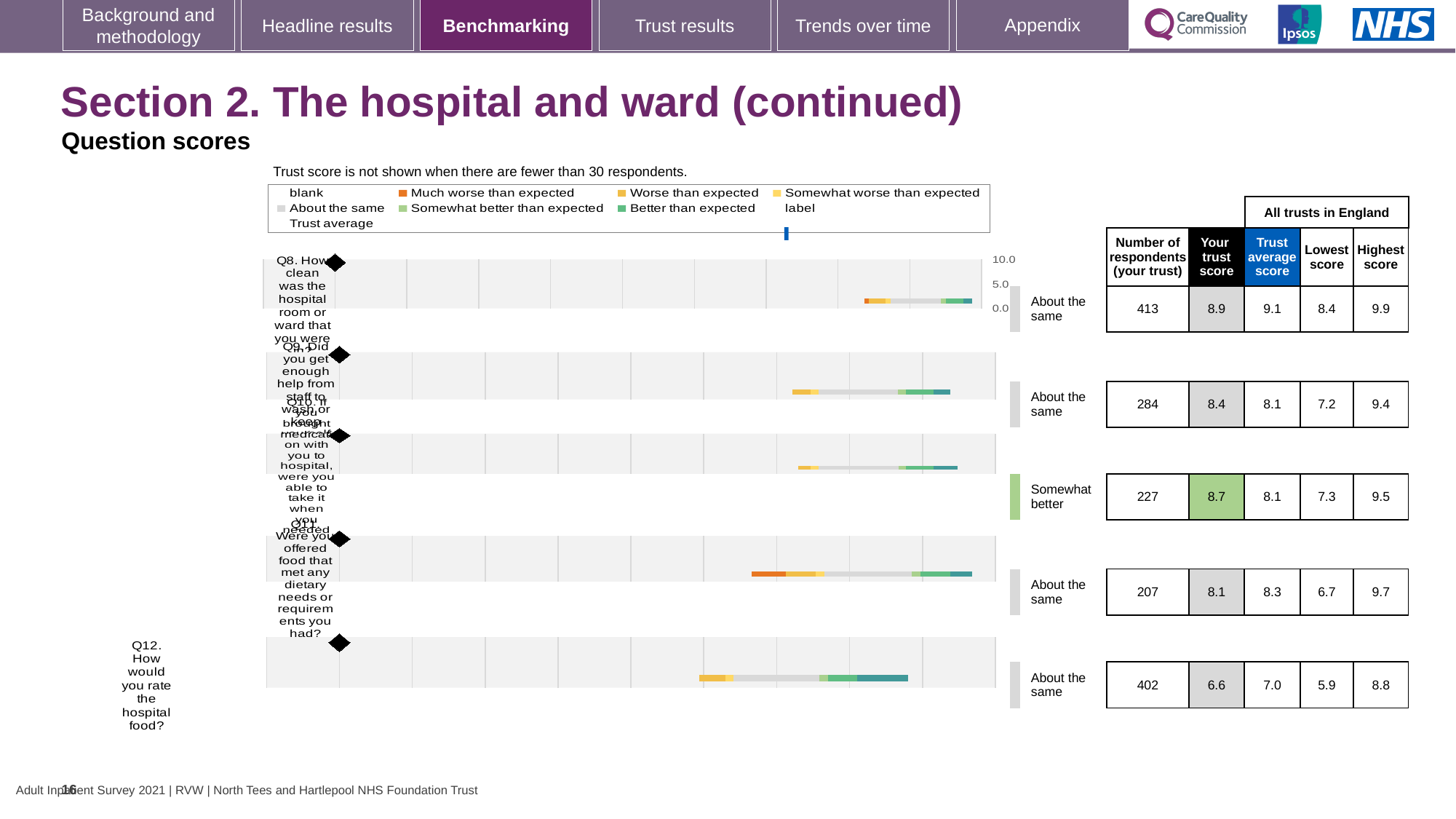
What kind of chart is used to show the question scores on this slide? bar chart What is the difference between the trust average score and your trust score for Q8? 0.2 How many questions (Q8 to Q12) are plotted in the chart? 5 What is the difference between the highest score and the lowest score for Q12? 2.9 What is the 'Your trust score' for Q8 (how clean was the hospital room or ward)? 8.9 For Q9, which is larger: your trust score or the trust average score? Your trust score Which question is rated 'Somewhat better' than expected? Q10 Which question has the highest 'Your trust score'? Q8 Which question has the lowest 'Your trust score'? Q12 How many respondents from your trust answered Q12 (how would you rate the hospital food)? 402 What is the lowest score across all trusts in England for Q12? 5.9 What is the trust average score for Q11 (offered food that met dietary needs)? 8.3